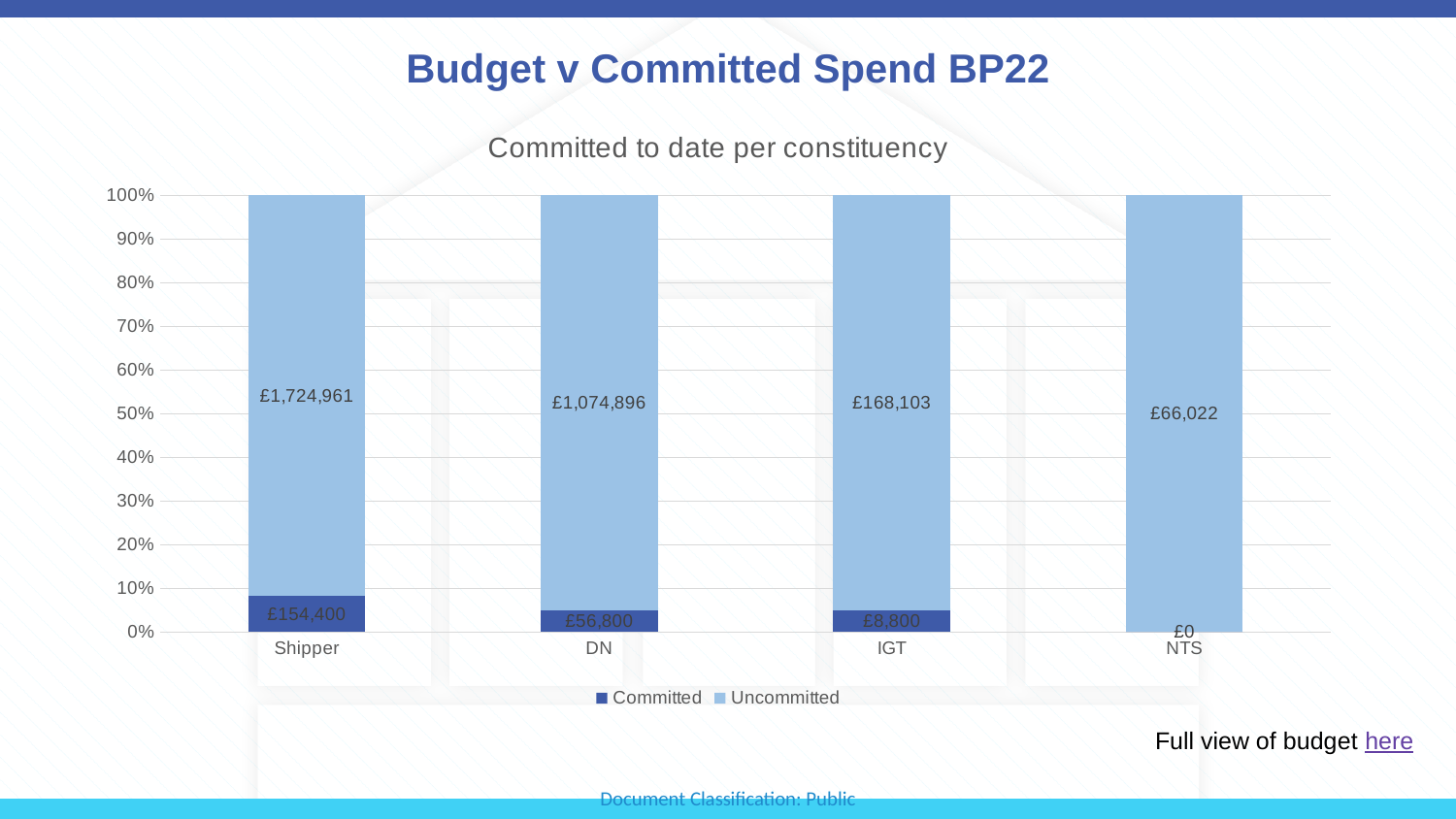
What is the Uncommitted value for IGT? £168,103 What is the Committed value for Shipper? £154,400 Which constituency has the highest Committed value? Shipper How many constituencies are shown on the x axis? 4 How many series does the legend list? 2 Which is larger, the Committed value for DN or the Committed value for IGT? DN What is the total of the Committed and Uncommitted values for IGT? £176,903 Which constituency has the lowest Uncommitted value? NTS What is the Uncommitted value for DN? £1,074,896 What kind of chart is shown on the slide? Stacked bar chart What is the difference between the Committed values for Shipper and DN? £97,600 What is the Committed value for NTS? £0